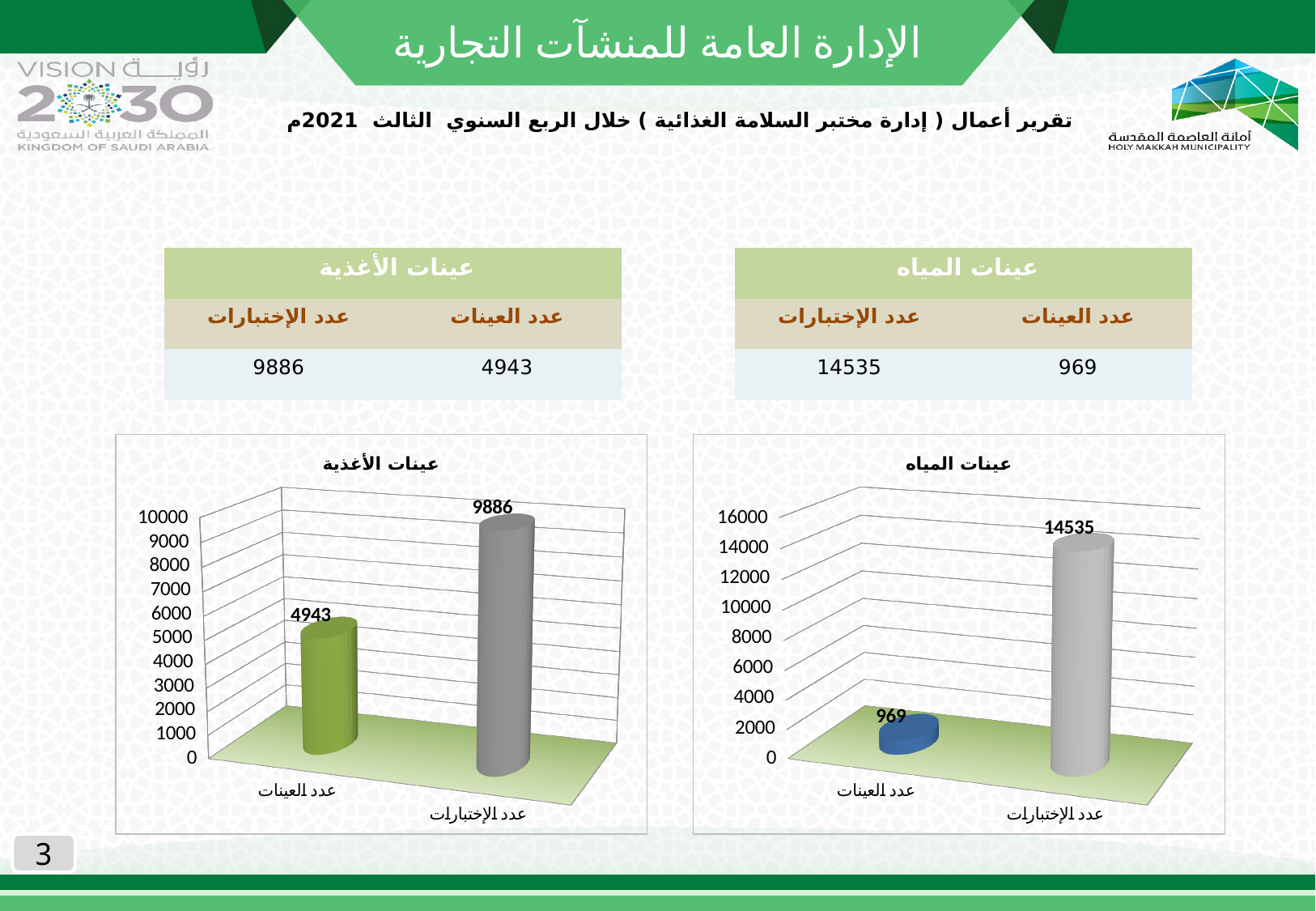
In the chart titled "عينات المياه", what is the value for "عدد الإختبارات"? 14535 In the chart titled "عينات المياه", is the value for "عدد الإختبارات" greater or less than 12000? greater In the chart titled "عينات الأغذية", what is the value for "عدد العينات"? 4943 In the chart titled "عينات الأغذية", which category has the highest value? عدد الإختبارات In the chart titled "عينات المياه", what is the difference between "عدد الإختبارات" and "عدد العينات"? 13566 In the chart titled "عينات المياه", which category has the lowest value? عدد العينات In the chart titled "عينات المياه", what is the value for "عدد العينات"? 969 What kind of chart is the chart titled "عينات المياه"? bar chart In the chart titled "عينات الأغذية", what is the difference between "عدد الإختبارات" and "عدد العينات"? 4943 In the chart titled "عينات الأغذية", what is the value for "عدد الإختبارات"? 9886 How many categories are shown in the chart titled "عينات الأغذية"? 2 What is the title of the chart on the left side of the slide? عينات الأغذية